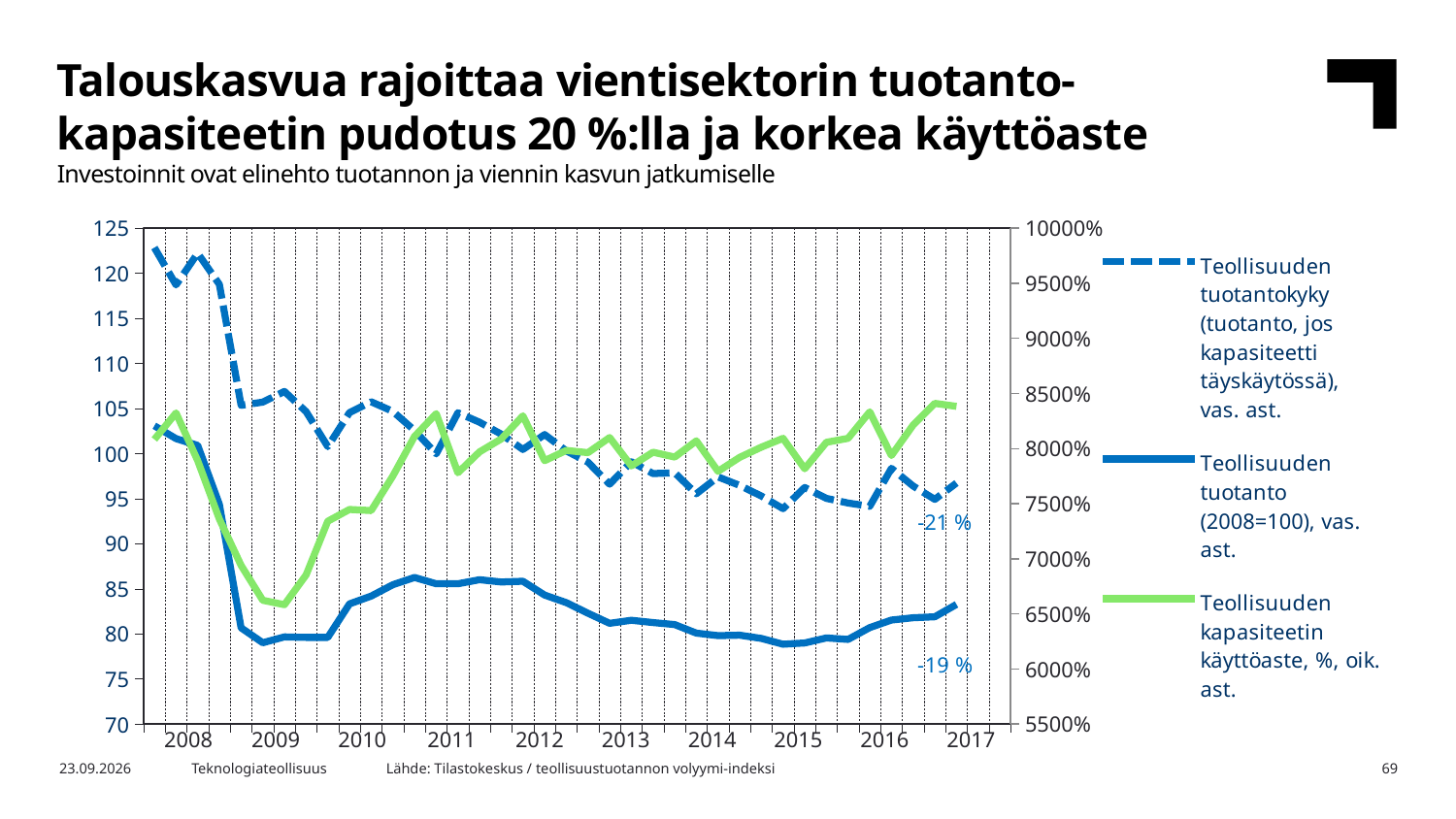
At 2009, which is higher on the left axis: the dashed 'Teollisuuden tuotantokyky' line or the solid 'Teollisuuden tuotanto (2008=100)' line? Teollisuuden tuotantokyky Does the 'Teollisuuden tuotanto (2008=100)' line rise or fall between 2008 and 2009? fall What kind of chart is shown on the slide? line chart What is the lowest value shown on the left vertical axis? 70 Which series is drawn as a dashed line? Teollisuuden tuotantokyky (tuotanto, jos kapasiteetti täyskäytössä), vas. ast. Is the value of the dashed 'Teollisuuden tuotantokyky' line at 2017 greater or less than 100? less What percentage annotation is printed near the end of the dashed 'Teollisuuden tuotantokyky' line? -21 % How many year labels are shown on the x axis? 10 Does the dashed 'Teollisuuden tuotantokyky' line overall rise or fall from 2008 to 2017? fall Is the value of the dashed 'Teollisuuden tuotantokyky' line at the start of 2008 greater or less than 120? greater Is the value of the 'Teollisuuden tuotanto (2008=100)' line at 2009 greater or less than 85? less How many series does the legend list? 3